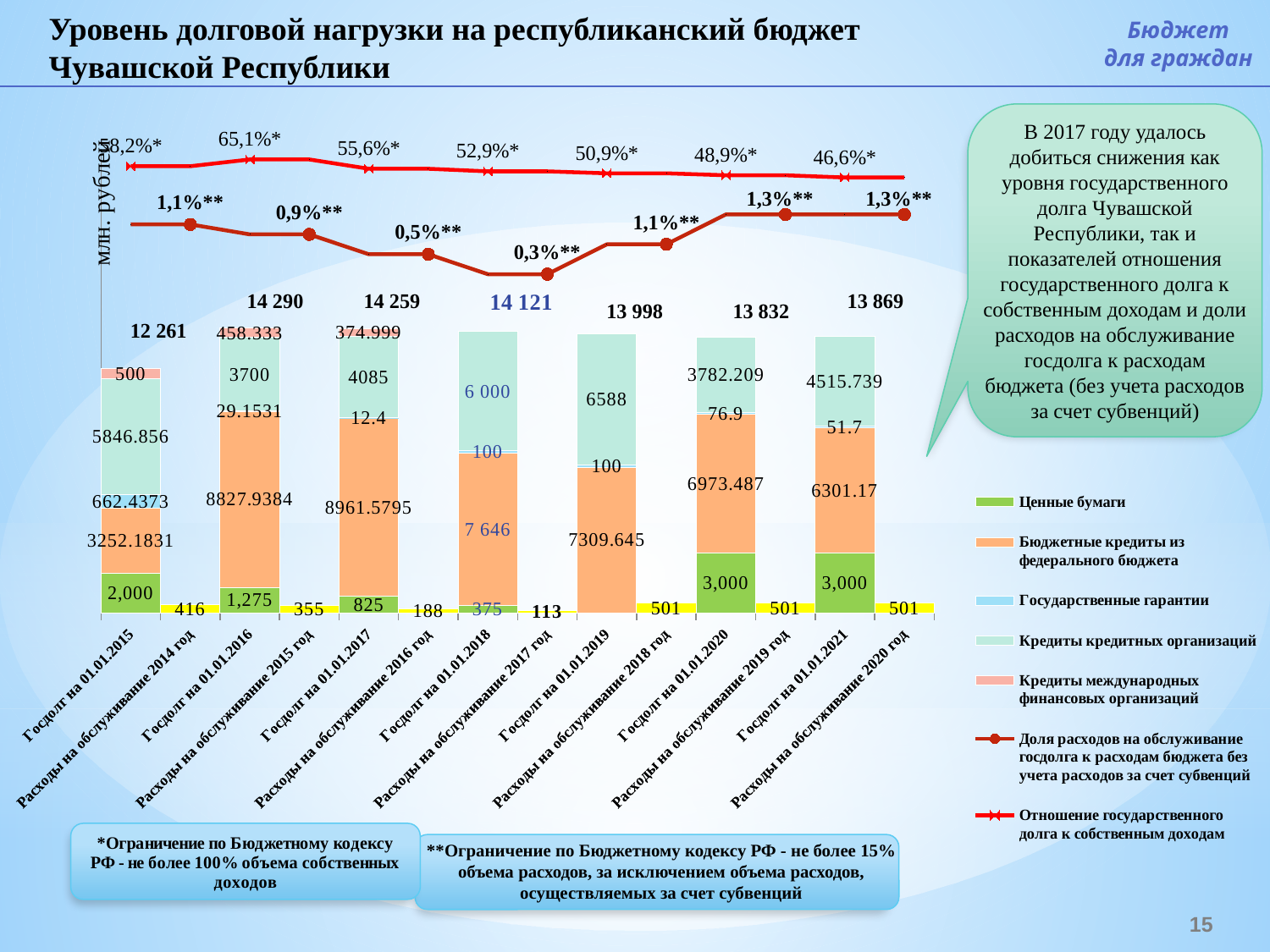
Which date has the highest total state debt (госдолг) among the stacked bars? Госдолг на 01.01.2016 Which date has the lowest total state debt (госдолг) among the stacked bars? Госдолг на 01.01.2015 What is the difference between the yellow bars for Расходы на обслуживание 2019 год (501) and 2017 год (113)? 388 Which is larger: the 'Кредиты кредитных организаций' segment for Госдолг на 01.01.2019 or for Госдолг на 01.01.2020? Госдолг на 01.01.2019 What is the value of the yellow bar for Расходы на обслуживание 2014 год? 416 What is the value of the 'Ценные бумаги' segment for Госдолг на 01.01.2020? 3,000 How many series does the legend list? 7 What is the total state debt (госдолг) shown above the bar for Госдолг на 01.01.2016? 14 290 Does the 'Отношение государственного долга к собственным доходам' line rise or fall from 01.01.2016 to 01.01.2021? fall What is the value of the 'Доля расходов на обслуживание госдолга' line for Расходы на обслуживание 2017 год? 0,3% What is the value of the 'Бюджетные кредиты из федерального бюджета' segment for Госдолг на 01.01.2019? 7309.645 What is the value of the 'Отношение государственного долга к собственным доходам' line for Госдолг на 01.01.2018? 52,9%